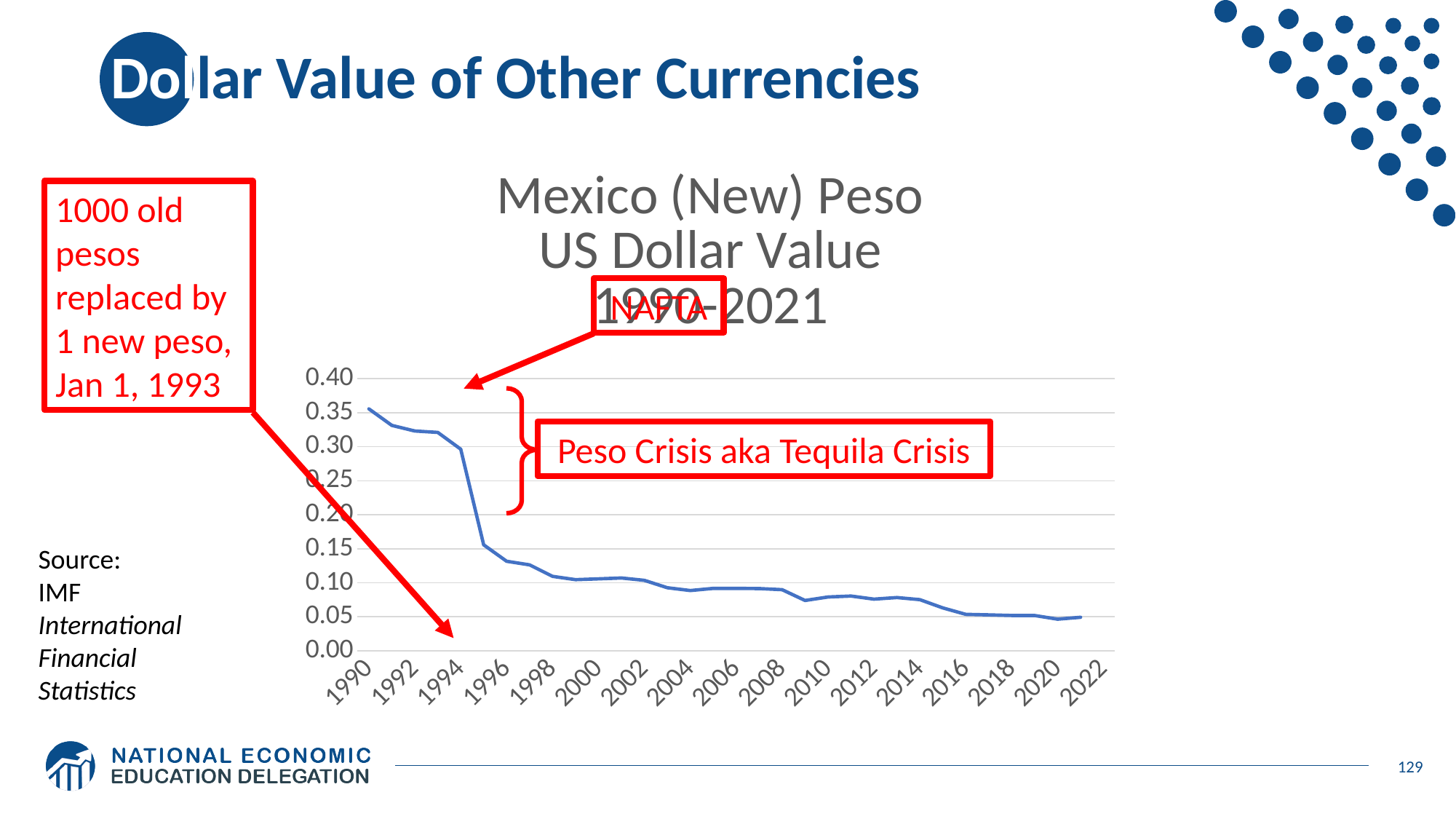
Is the value for 2004 greater or less than 0.05? greater Is the value for 1996 greater or less than 0.15? less Which year has the larger value, 1994 or 1996? 1994 What is the title of the chart? Mexico (New) Peso US Dollar Value 1990-2021 In which year shown on the x axis is the peso's US dollar value highest? 1990 What crisis does the red annotation label the sharp drop in the mid-1990s as? Peso Crisis aka Tequila Crisis How many year labels are shown on the x axis? 17 What kind of chart is shown on the slide? line chart Is the value for 1990 greater or less than 0.30? greater Does the US dollar value of the Mexican peso rise or fall from 1990 to 2021? fall